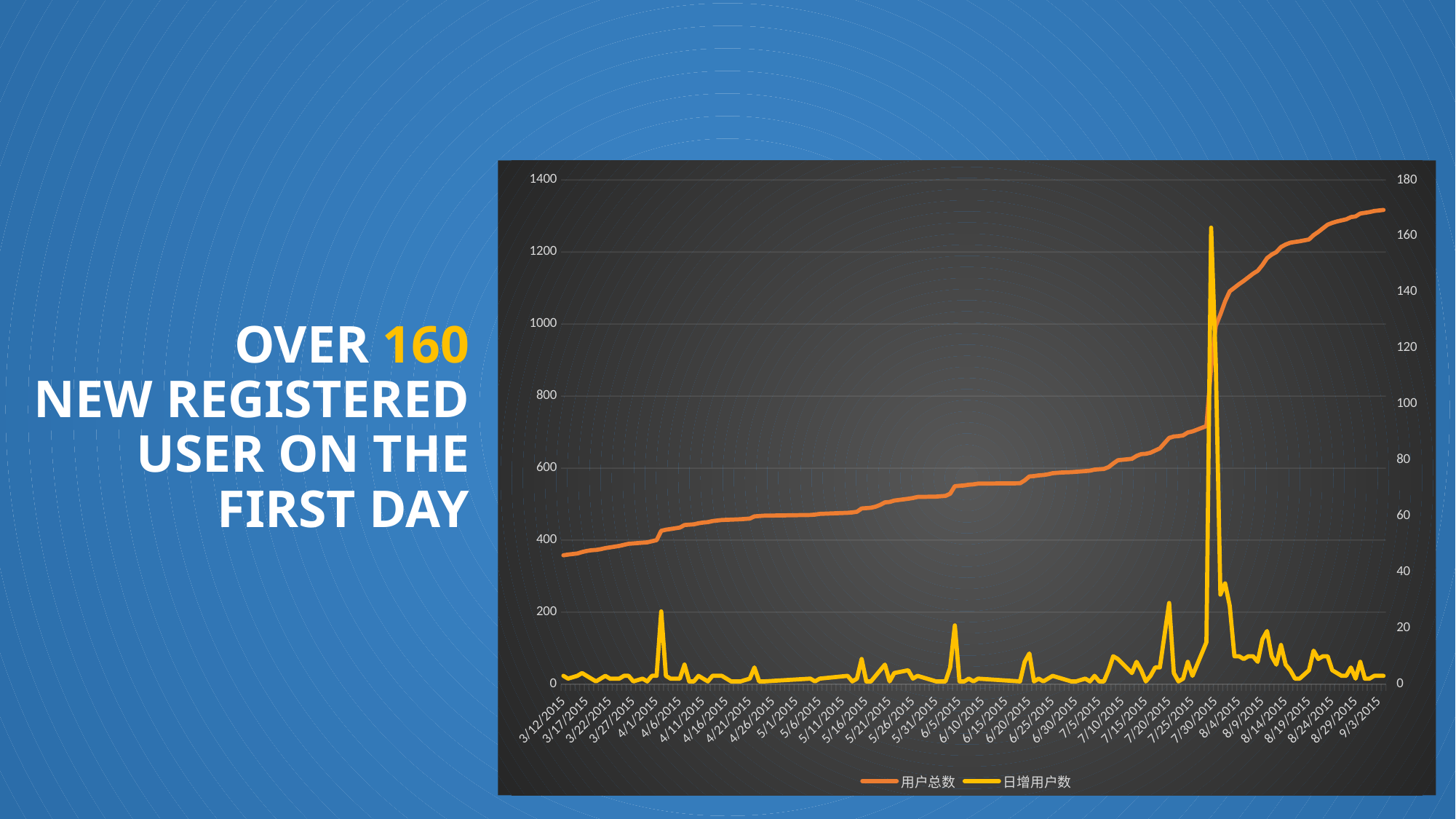
Which series is plotted in yellow? 日增用户数 How many series does the chart's legend list? 2 Is the value of 用户总数 at 6/5/2015 greater or less than 800 on the left axis? less Is the value of 用户总数 at 3/12/2015 greater or less than 400 on the left axis? less What are the two series named in the legend? 用户总数 and 日增用户数 Does the 用户总数 series rise or fall from 3/12/2015 to 9/3/2015? rise What is the maximum value shown on the left vertical axis? 1400 What kind of chart is shown on the slide? line chart In which month of 2015 does the 日增用户数 series reach its highest peak? July Is the value of 日增用户数 at 4/1/2015 greater or less than 40 on the right axis? less